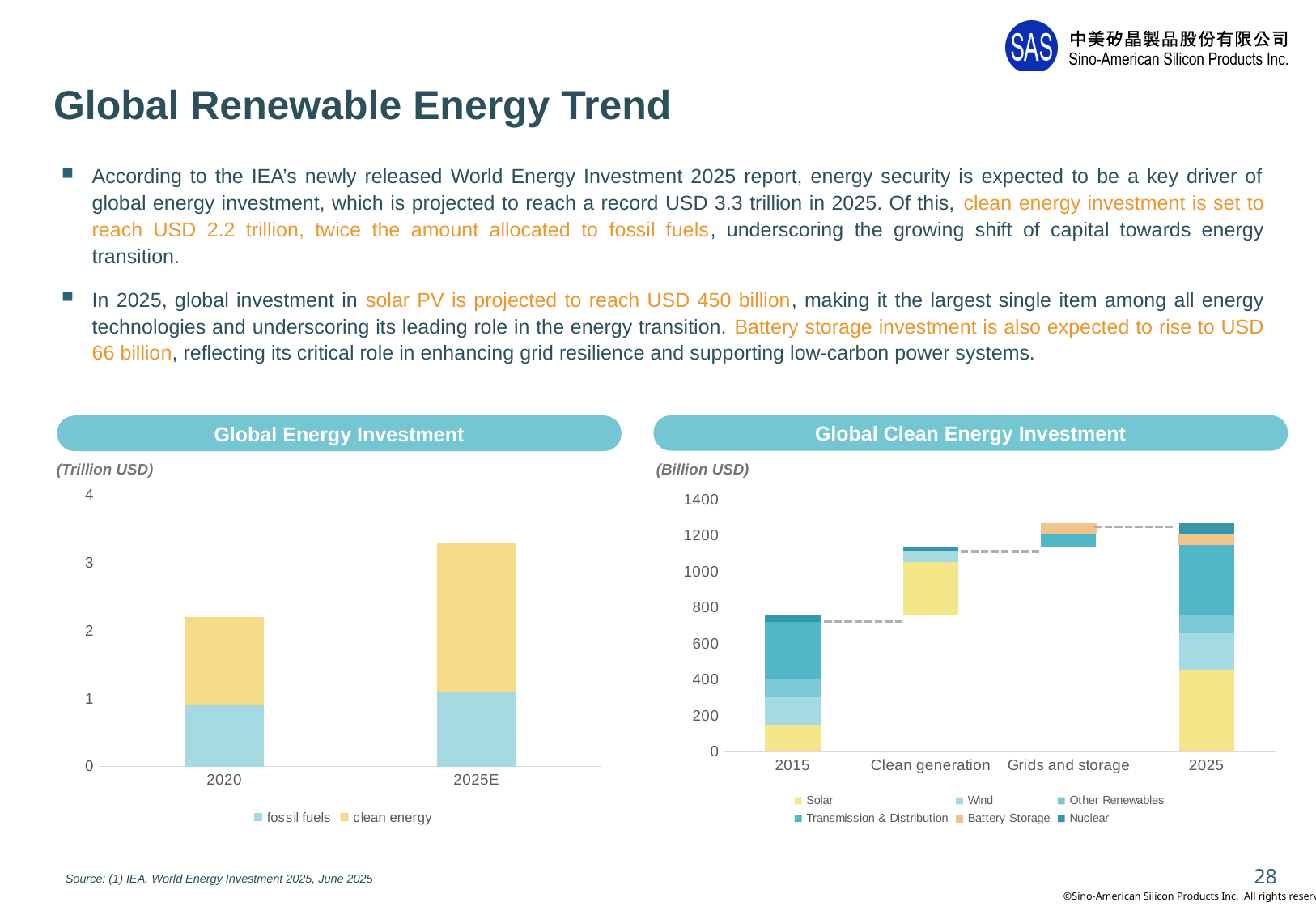
In the Global Clean Energy Investment chart, is the total for 2025 greater or less than 1200 billion USD? greater In the Global Energy Investment chart, is the total for 2025E greater or less than 3 trillion USD? greater What kind of chart is the Global Energy Investment chart? bar chart In the Global Clean Energy Investment chart, is the total for 2015 greater or less than 800 billion USD? less In the Global Energy Investment chart, which is larger in 2025E, fossil fuels or clean energy? clean energy In the Global Clean Energy Investment chart, what unit is stated above the y axis? Billion USD In the Global Energy Investment chart, how many series does the legend list? 2 In the Global Clean Energy Investment chart, how many categories are shown on the x axis? 4 In the Global Energy Investment chart, does total investment rise or fall from 2020 to 2025E? rise In the Global Energy Investment chart, how many categories are shown on the x axis? 2 In the Global Clean Energy Investment chart, how many series does the legend list? 6